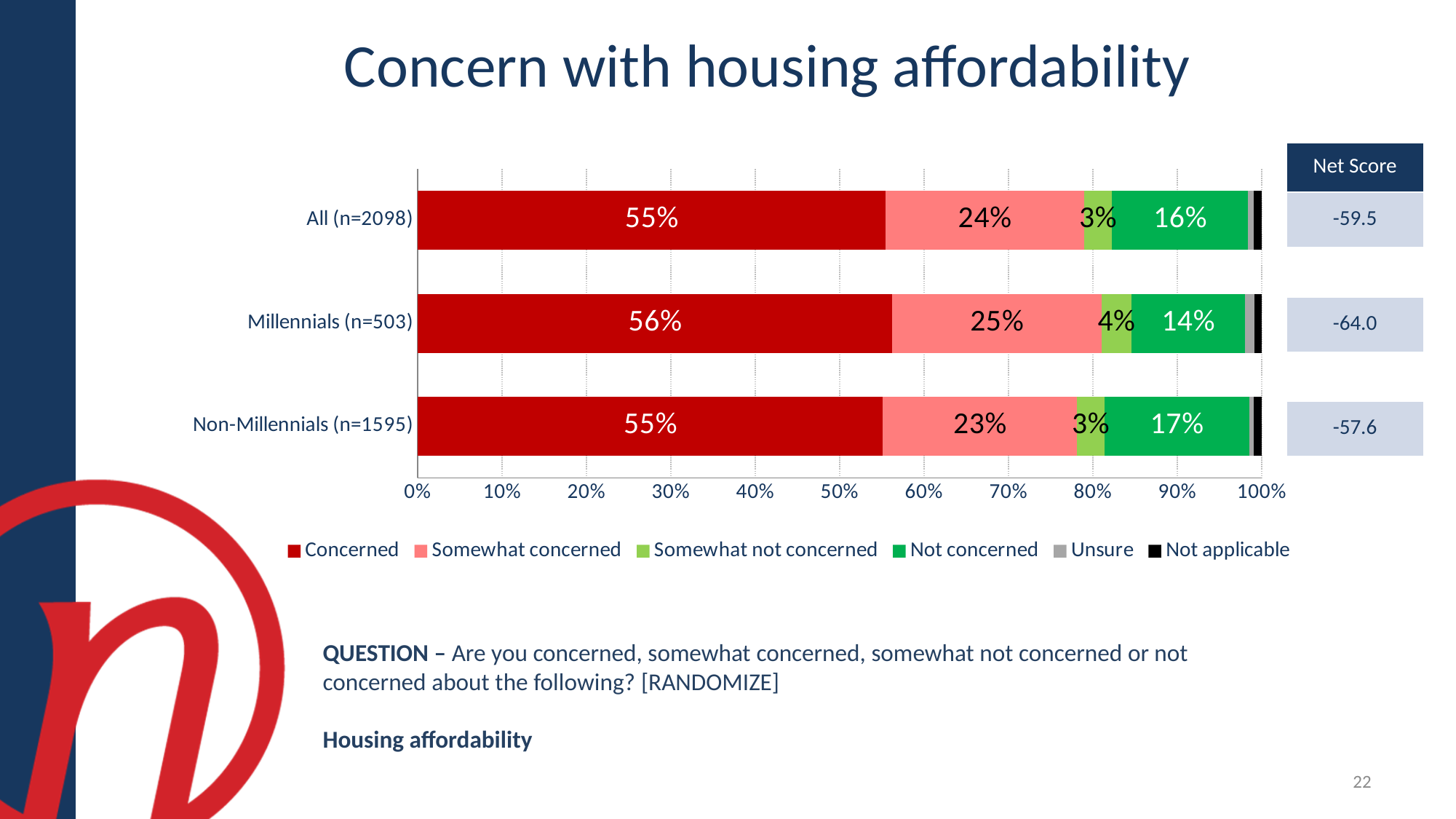
How many series does the legend list? 6 Which group has the highest Concerned percentage? Millennials (n=503) What percentage of Non-Millennials (n=1595) are Not concerned? 17% Which group has the lowest Not concerned percentage? Millennials (n=503) What kind of chart is shown on the slide? Stacked bar chart Which is larger: the Not concerned percentage for All (n=2098) or for Non-Millennials (n=1595)? Non-Millennials (n=1595) What percentage of Millennials (n=503) are Somewhat concerned? 25% What percentage of All (n=2098) respondents are Concerned about housing affordability? 55% What is the title of the slide's chart? Concern with housing affordability What is the difference between the Somewhat concerned percentages for Millennials (n=503) and Non-Millennials (n=1595)? 2% How many groups (bars) are shown in the chart? 3 What is the Net Score for Millennials (n=503)? -64.0